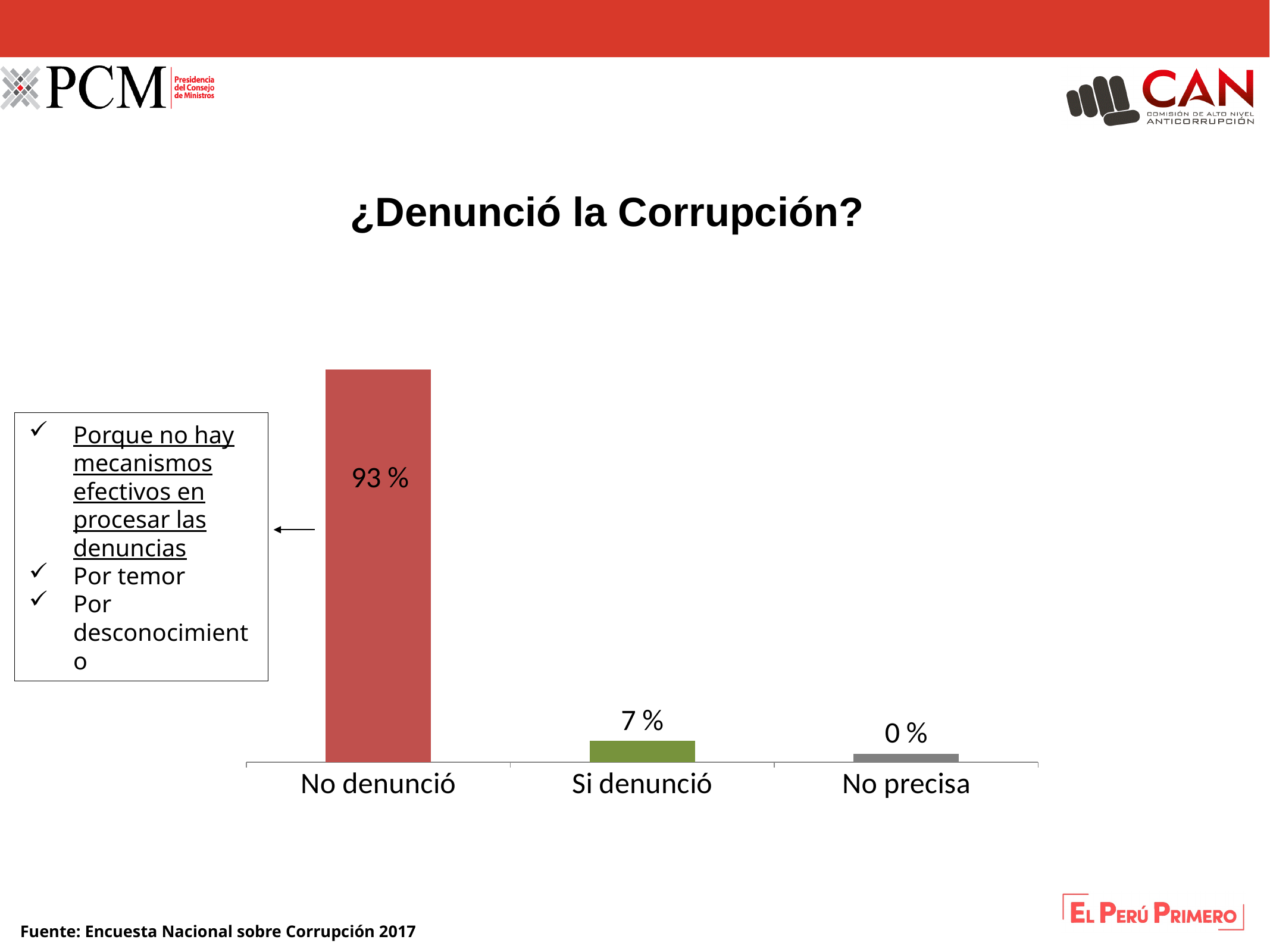
What is the value for Si denunció? 7 % Do the values rise or fall from left to right across the categories? Fall What is the value for No denunció? 93 % What kind of chart is shown on the slide? Bar chart How many categories are shown in the chart? 3 Which category has the lowest value? No precisa What is the value for No precisa? 0 % Which is larger, the value for Si denunció or the value for No precisa? Si denunció What is the difference between the values for No denunció and Si denunció? 86 % Which category has the highest value? No denunció What colour is the bar for Si denunció? Green What is the title of the slide above the chart? ¿Denunció la Corrupción?